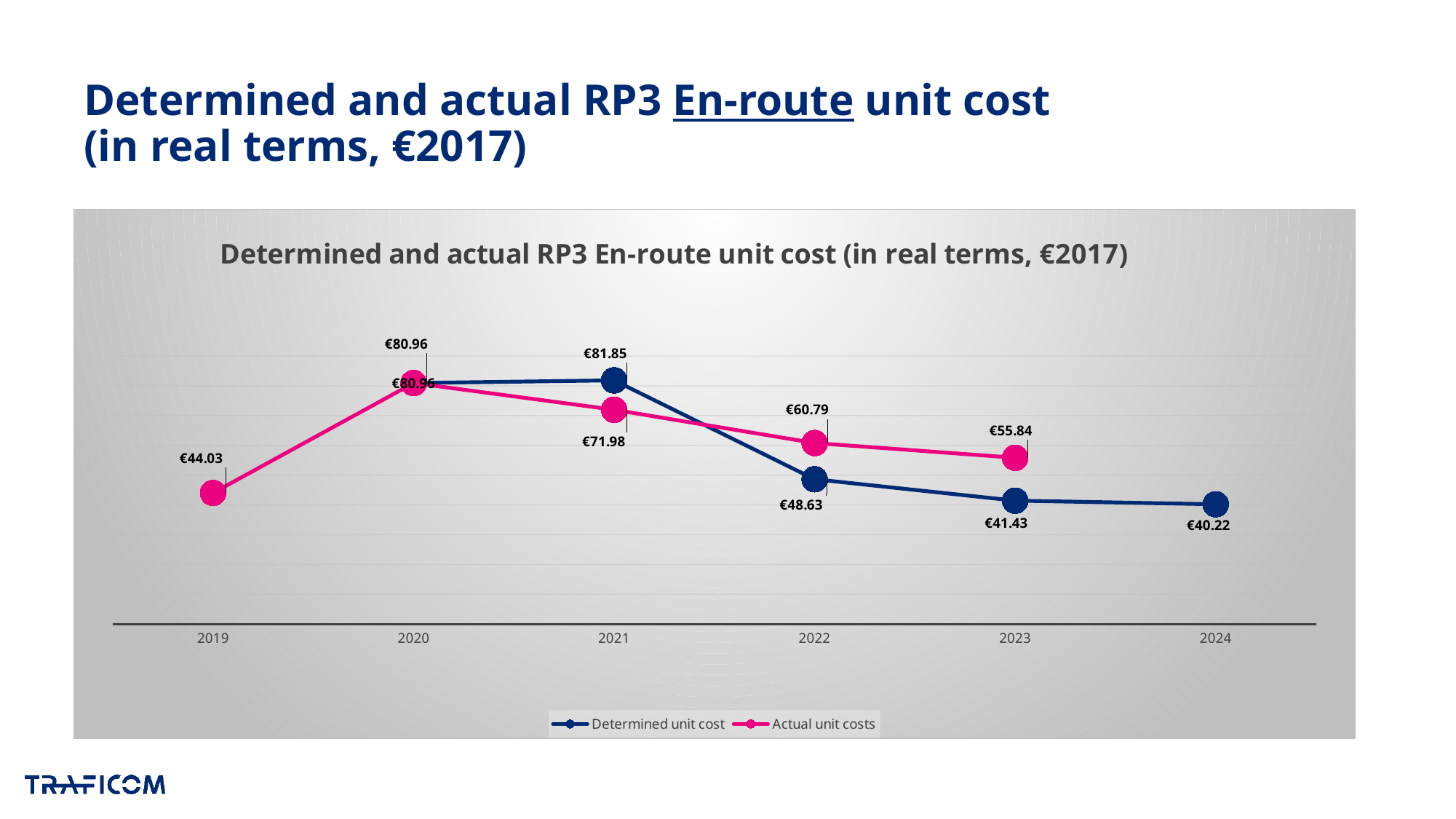
In which year is the Determined unit cost highest? 2021 What is the Determined unit cost for 2024? €40.22 How many years are shown on the x axis? 6 In which year is the Actual unit cost lowest? 2019 What is the Actual unit cost for 2019? €44.03 How many series does the legend list? 2 What is the difference between the Actual unit cost and the Determined unit cost in 2023? €14.41 In 2022, which is larger: the Determined unit cost or the Actual unit cost? Actual unit cost What is the Actual unit cost for 2022? €60.79 What is the Determined unit cost for 2021? €81.85 Does the Determined unit cost rise or fall from 2021 to 2024? Fall What kind of chart is shown on the slide? Line chart